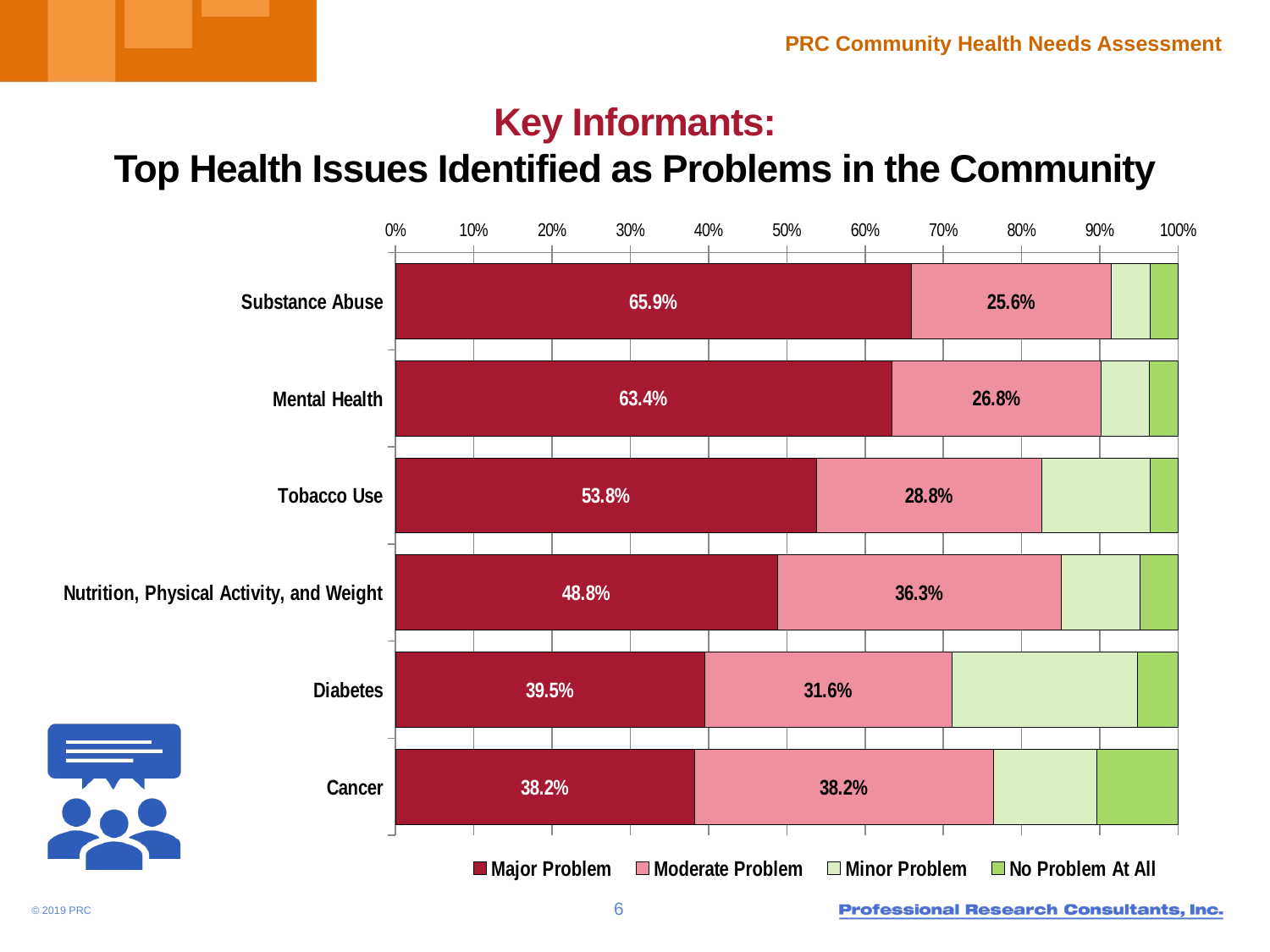
Is the Major Problem value for Tobacco Use greater or less than 50%? greater How many series does the legend list? 4 Which health issue has the lowest Major Problem percentage? Cancer What is the Major Problem value for Diabetes? 39.5% What percentage of key informants rated Substance Abuse a Major Problem? 65.9% What is the Moderate Problem value for Nutrition, Physical Activity, and Weight? 36.3% What is the difference between the Major Problem values for Substance Abuse and Mental Health? 2.5% Which legend entry is shown in the darkest red colour? Major Problem Which is larger, the Moderate Problem value for Tobacco Use or for Diabetes? Diabetes What kind of chart is shown on the slide? Stacked bar chart Which health issue has the highest Major Problem percentage? Substance Abuse How many health issues are shown on the chart? 6